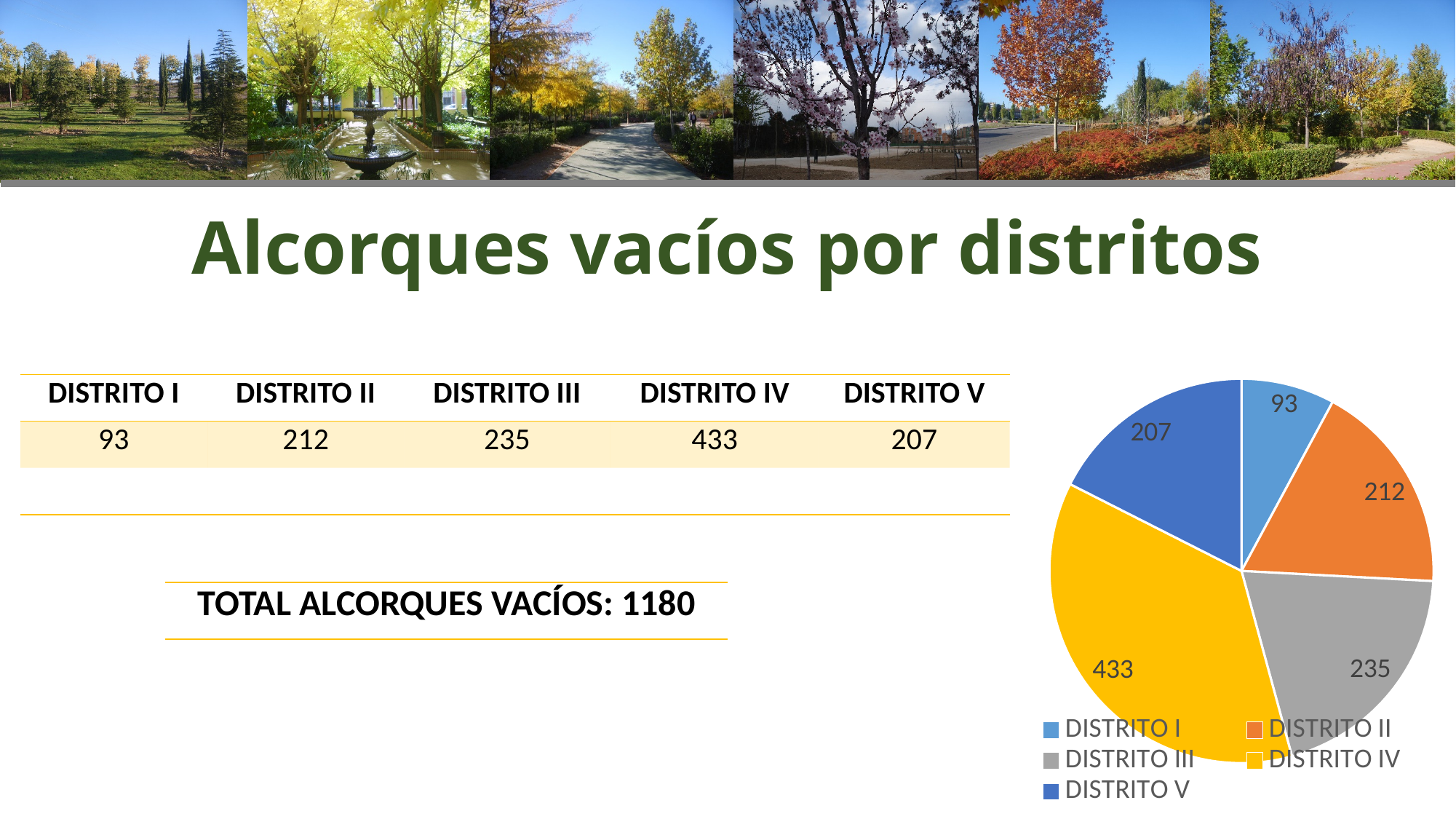
Which colour represents DISTRITO IV in the pie chart? Yellow Which district has the largest slice in the pie chart? DISTRITO IV What is the difference between the values for DISTRITO II and DISTRITO I? 119 Which district has the smallest slice in the pie chart? DISTRITO I Which is larger, the value for DISTRITO III or the value for DISTRITO V? DISTRITO III What is the difference between the values for DISTRITO IV and DISTRITO III? 198 What is the total of all the slices in the pie chart? 1180 What kind of chart is shown on the slide? Pie chart How many slices does the pie chart have? 5 What is the value for DISTRITO IV in the pie chart? 433 What is the value for DISTRITO I in the pie chart? 93 What is the value for DISTRITO V in the pie chart? 207